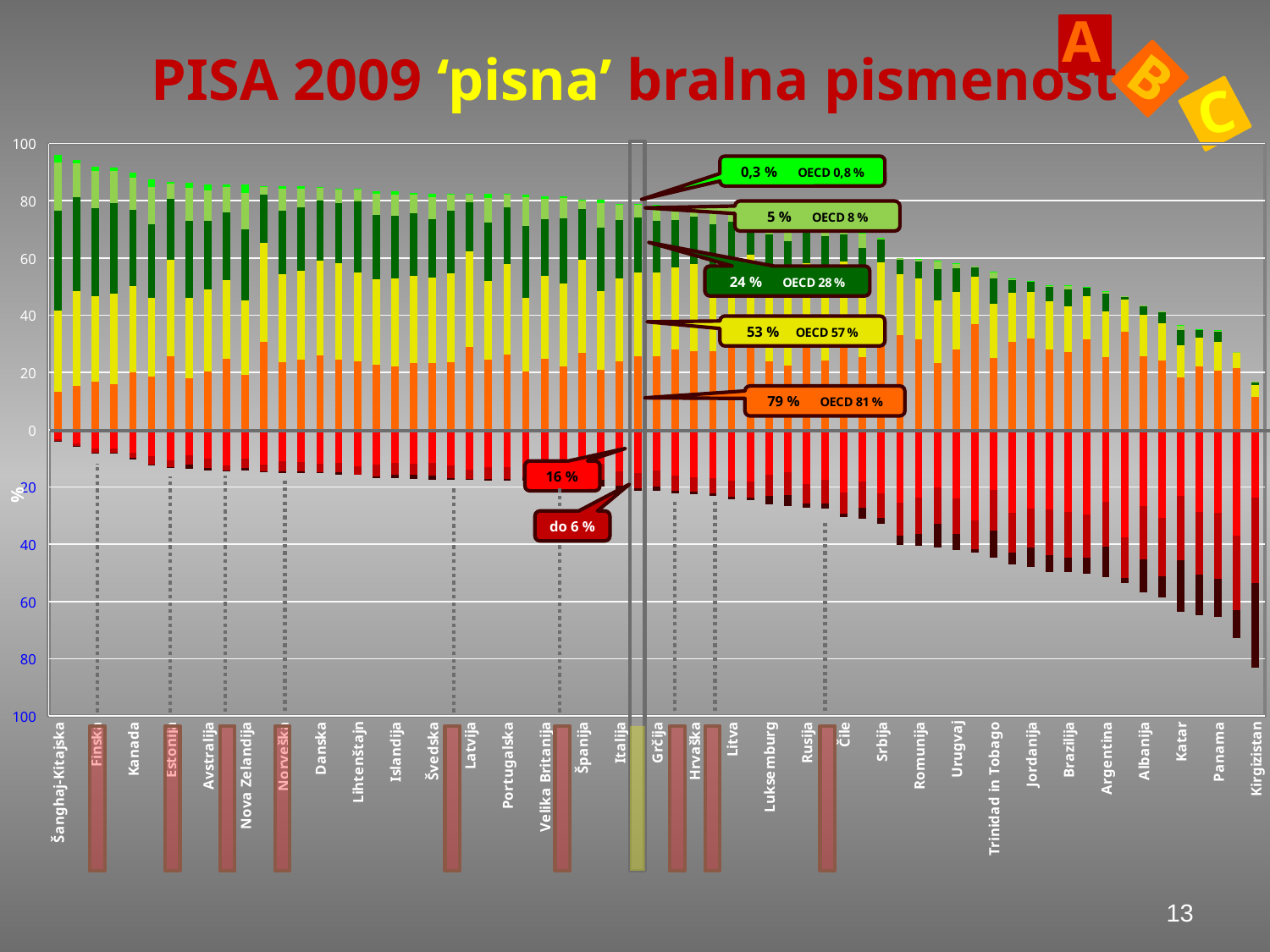
Which country has the tallest positive (above zero) stacked bar? Šanghaj-Kitajska Which country has the shortest positive (above zero) stacked bar? Kirgizistan What is the title of the chart on the slide? PISA 2009 'pisna' bralna pismenost What kind of chart is shown on the slide? bar chart In the callout showing 24 %, what is the OECD value given? OECD 28 % In the callout showing 53 %, which is larger: the 53 % value or the OECD value? OECD value (57 %) What is the difference between the OECD value and the country value in the callout showing 79 % and OECD 81 %? 2 percentage points Do the positive stacked bar heights rise or fall moving from left to right along the x axis? fall